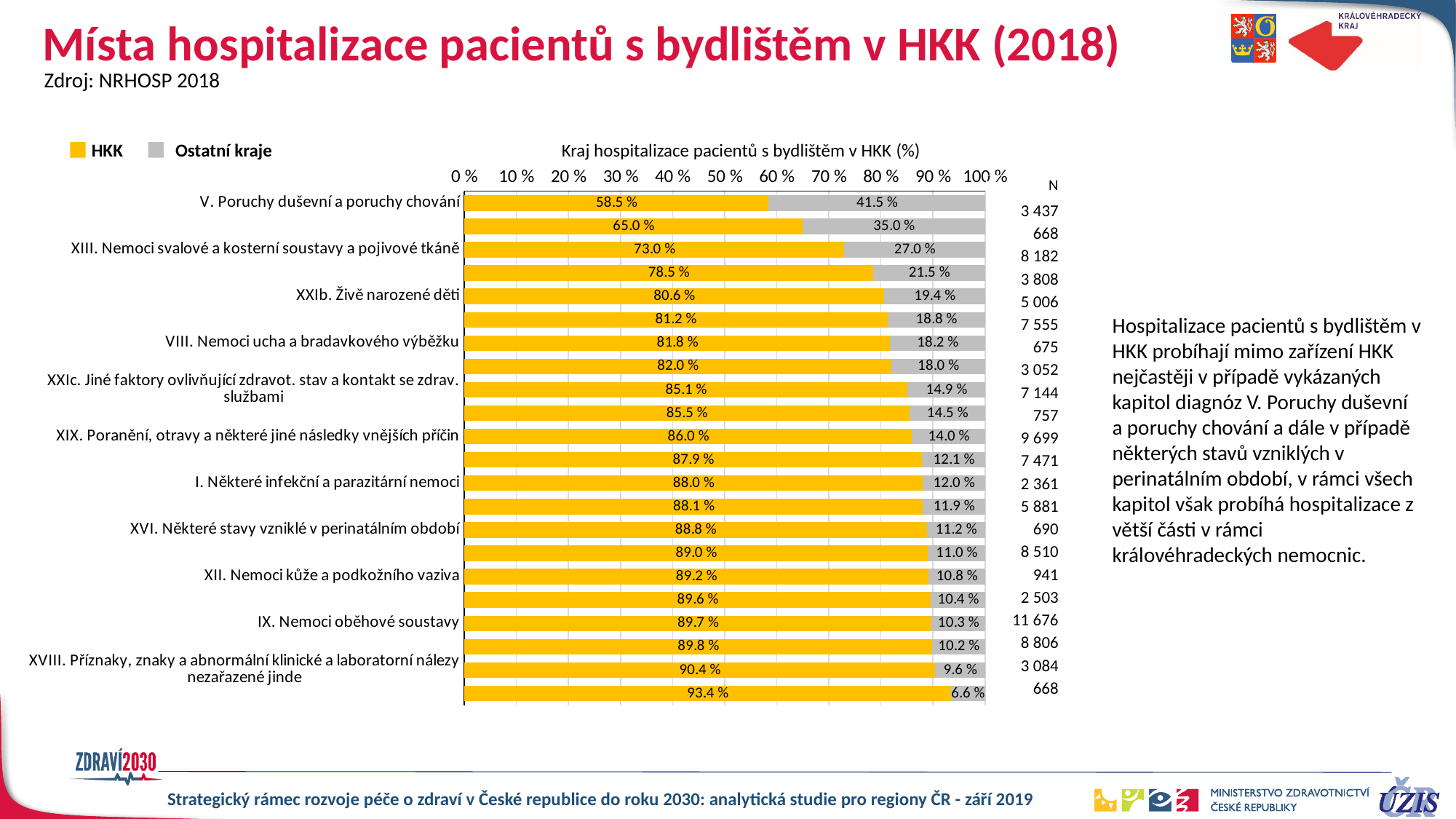
What is the N value shown for IX. Nemoci oběhové soustavy? 11 676 What is the HKK value for XXIb. Živě narozené děti? 80.6 % Which has a larger HKK share: XIX. Poranění, otravy a některé jiné následky vnějších příčin or VIII. Nemoci ucha a bradavkového výběžku? XIX. Poranění, otravy a některé jiné následky vnějších příčin How many series does the legend list? 2 What is the Ostatní kraje value for XIII. Nemoci svalové a kosterní soustavy a pojivové tkáně? 27.0 % What are the two series named in the legend? HKK and Ostatní kraje Which labelled category has the lowest HKK share? V. Poruchy duševní a poruchy chování What is the total of the stacked bar for XVI. Některé stavy vzniklé v perinatálním období? 100.0 % What kind of chart is shown on the slide? bar chart What is the HKK value for V. Poruchy duševní a poruchy chování? 58.5 % How many bars are plotted in the chart? 22 What is the difference between the HKK values for XVIII. Příznaky, znaky a abnormální klinické a laboratorní nálezy nezařazené jinde and I. Některé infekční a parazitární nemoci? 2.4 %